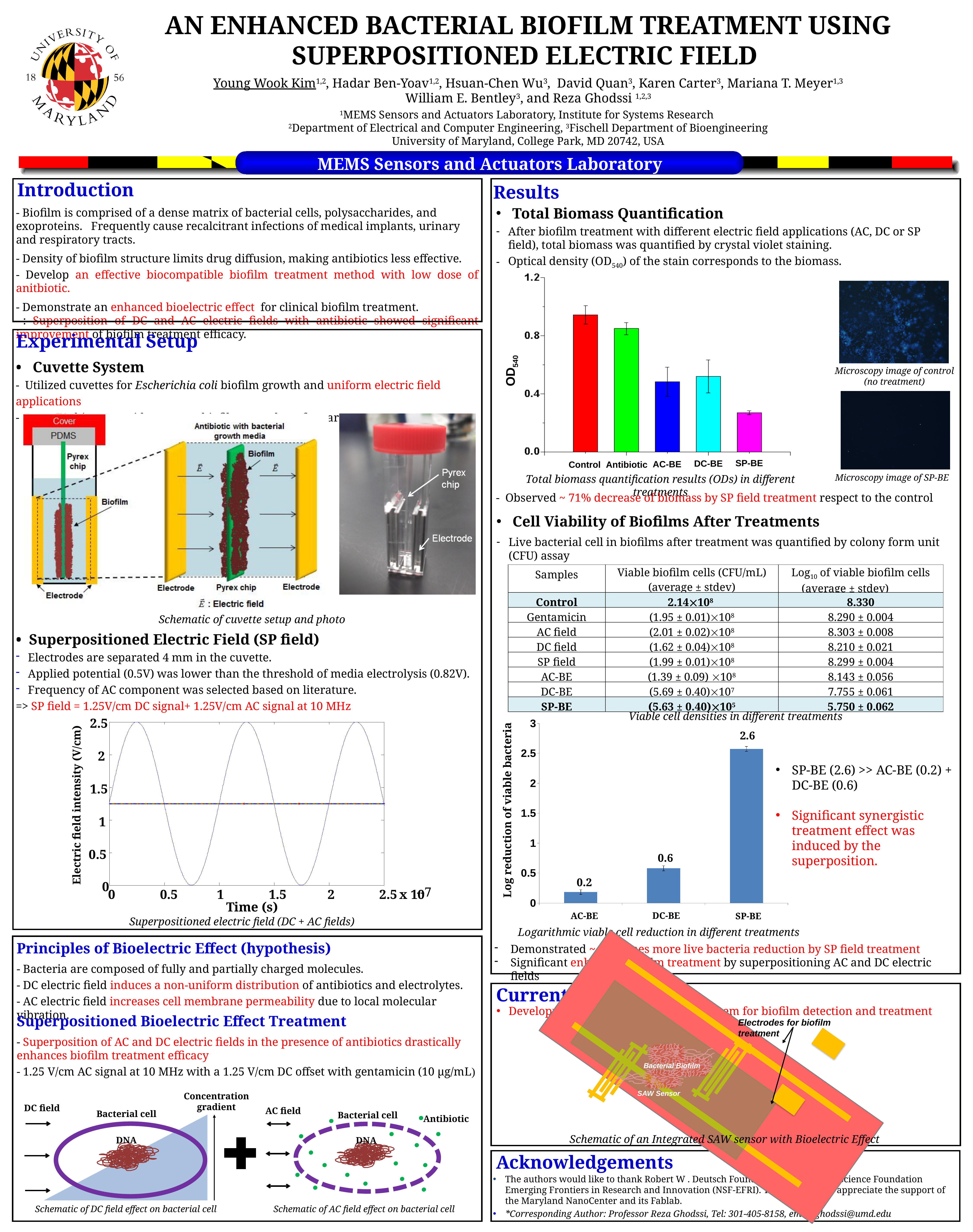
In the 'Total biomass quantification results' chart, which treatment has the lowest OD540? SP-BE In the 'Logarithmic viable cell reduction in different treatments' chart, what is the log reduction value for SP-BE? 2.6 What kind of chart is the 'Superpositioned electric field (DC + AC fields)' figure? line chart In the 'Logarithmic viable cell reduction in different treatments' chart, do the values rise or fall from AC-BE to SP-BE? rise In the 'Logarithmic viable cell reduction in different treatments' chart, how many treatments are plotted? 3 In the 'Total biomass quantification results' chart, which category has the highest OD540? Control In the 'Logarithmic viable cell reduction in different treatments' chart, what is the log reduction value for AC-BE? 0.2 In the 'Logarithmic viable cell reduction in different treatments' chart, which treatment has the highest log reduction? SP-BE In the 'Total biomass quantification results' chart, is the OD540 value for SP-BE greater or less than 0.4? less In the 'Logarithmic viable cell reduction in different treatments' chart, what is the difference between the SP-BE and DC-BE values? 2.0 In the 'Total biomass quantification results' chart, how many categories are shown on the x axis? 5 In the 'Logarithmic viable cell reduction in different treatments' chart, what is the log reduction value for DC-BE? 0.6